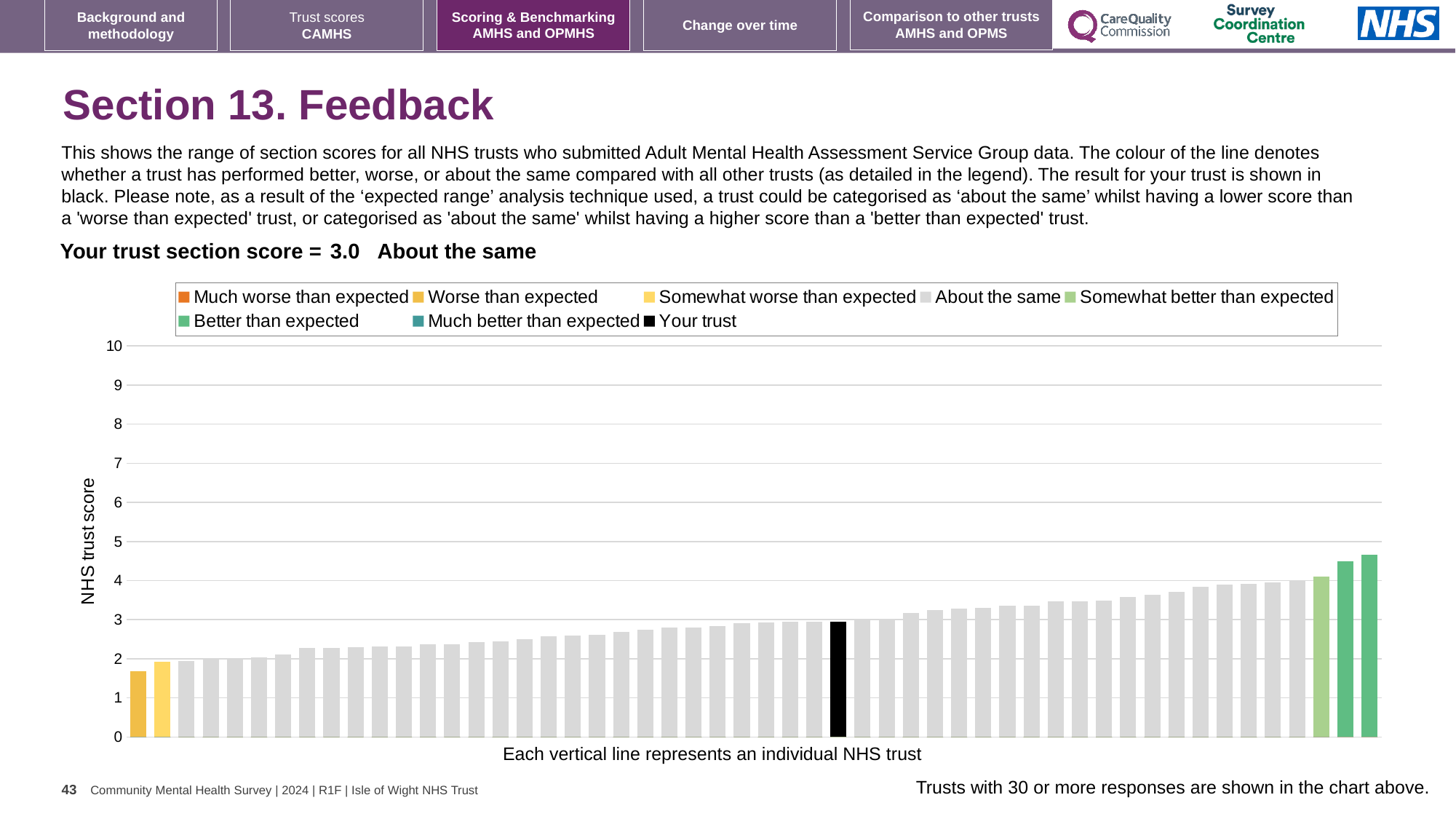
Do the bar values rise or fall from left to right across the chart? rise What is the label on the vertical axis of the chart? NHS trust score Is the value of the tallest bar in the chart greater or less than 4? greater Is the value of the shortest bar in the chart greater or less than 2? less Is the value of the black 'Your trust' bar greater or less than 2? greater What is the section score for your trust shown on the slide? 3.0 Which category does your trust's section score fall into? About the same What kind of chart is shown on the slide? bar chart How many entries does the chart legend list? 8 What colour is the bar representing your trust? black How many bars are shown in the 'Better than expected' colour? 2